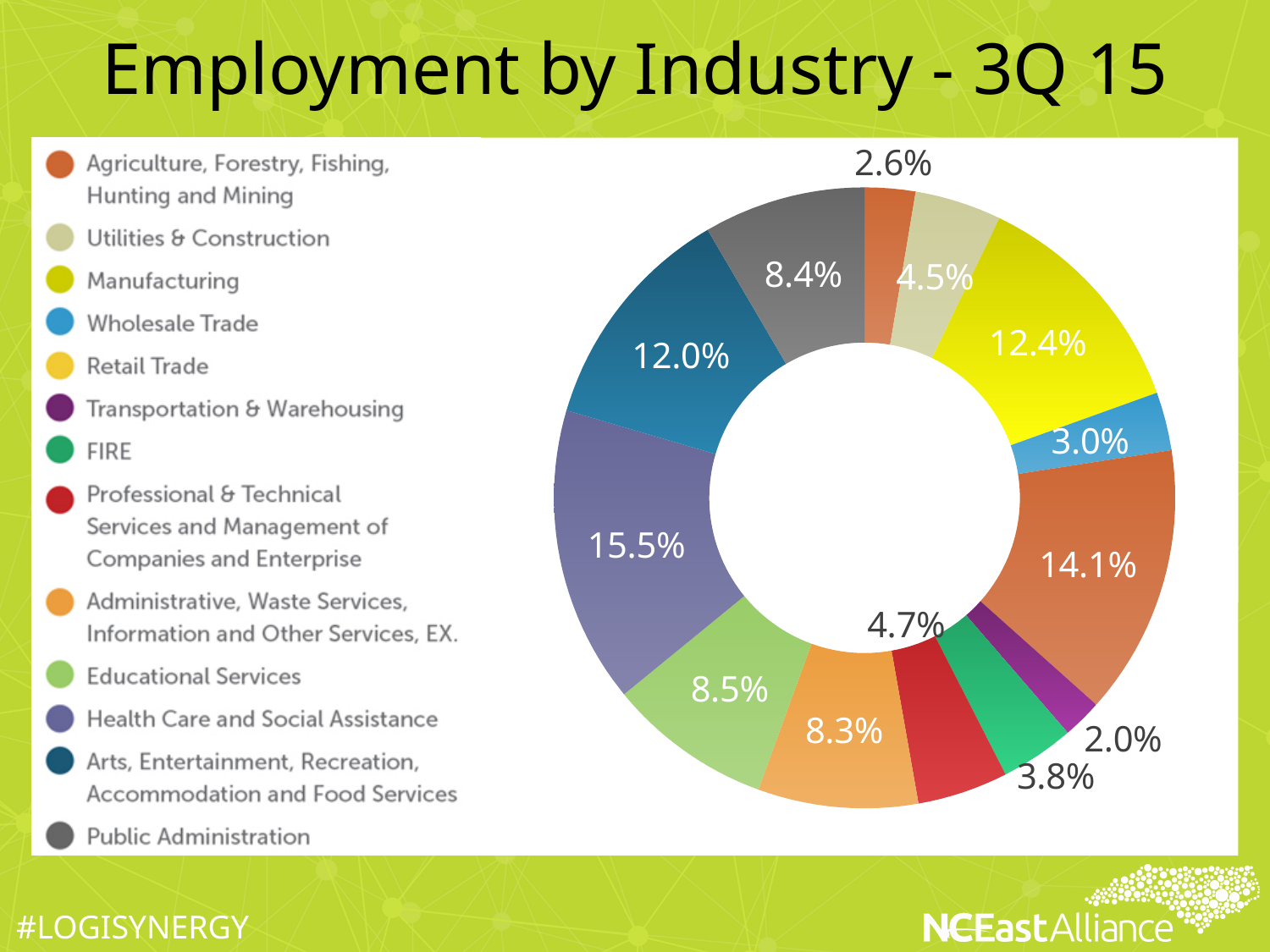
What is the title of the chart? Employment by Industry - 3Q 15 How many industry categories does the legend list? 13 What is the difference between the Health Care and Social Assistance share and the Manufacturing share? 3.1% What share of employment is Arts, Entertainment, Recreation, Accommodation and Food Services? 12.0% What share of employment is Educational Services? 8.5% What type of chart is shown on the slide? Pie (donut) chart What share of employment is Manufacturing? 12.4% Which industry has the largest share of employment? Health Care and Social Assistance What share of employment is Health Care and Social Assistance? 15.5% Which is larger, the share for Wholesale Trade or the share for Utilities & Construction? Utilities & Construction What share of employment is Public Administration? 8.4% Which industry has the smallest share of employment? Transportation & Warehousing